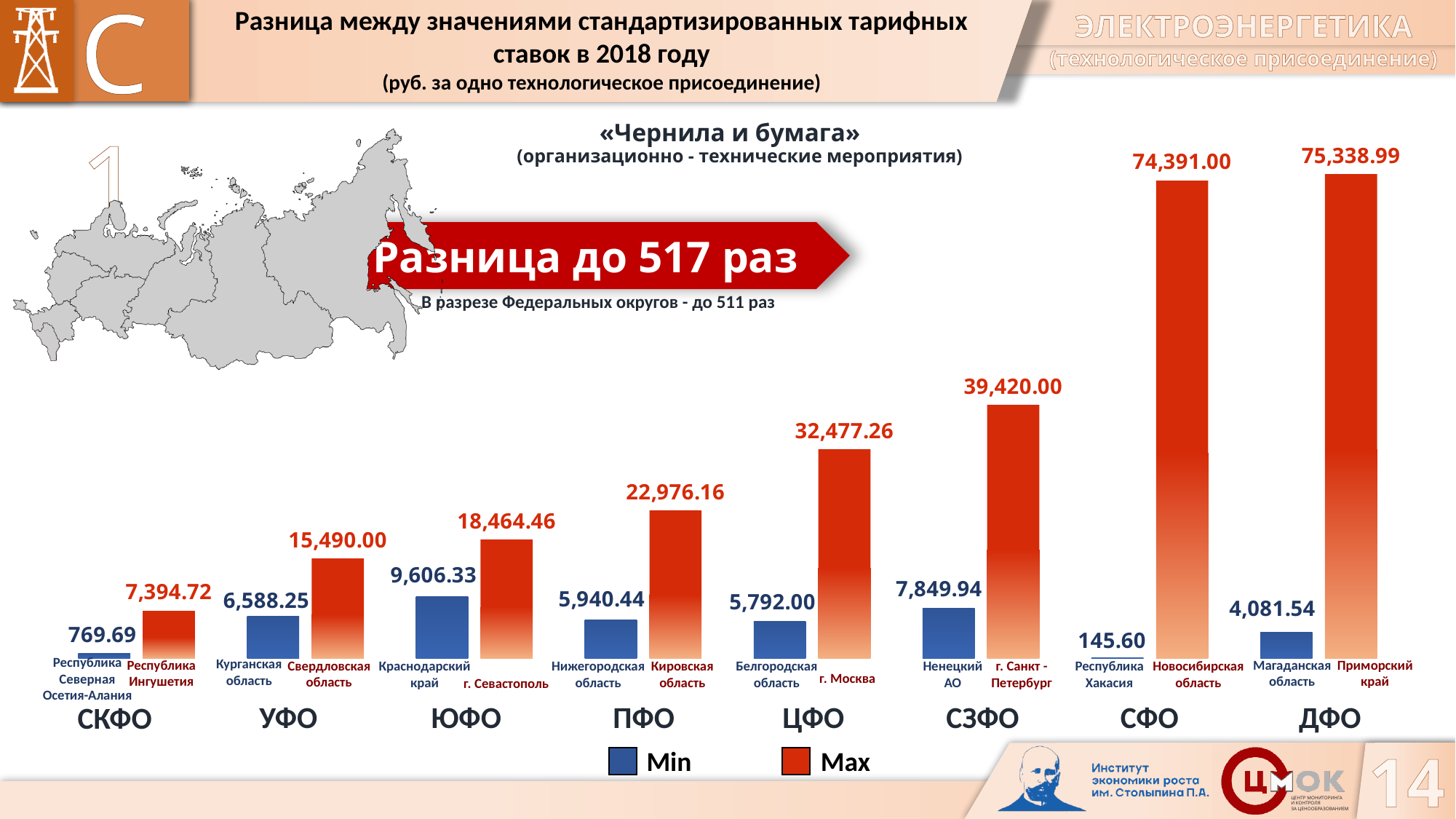
Which region is labelled as the Max bar for СЗФО? г. Санкт-Петербург Which federal district has the lowest Min value? СФО What is the Min value for СКФО? 769.69 What type of chart is shown on the slide? bar chart Which federal district has the highest Max value? ДФО Which is larger, the Min value for ЮФО or the Min value for СЗФО? ЮФО What is the Max value for СФО? 74,391.00 How many federal districts are shown on the x axis of the chart? 8 How many series does the legend list? 2 What is the Max value for ЦФО? 32,477.26 What is the difference between the Max values of ДФО and СФО? 947.99 What is the difference between the Max and Min values for ДФО? 71,257.45